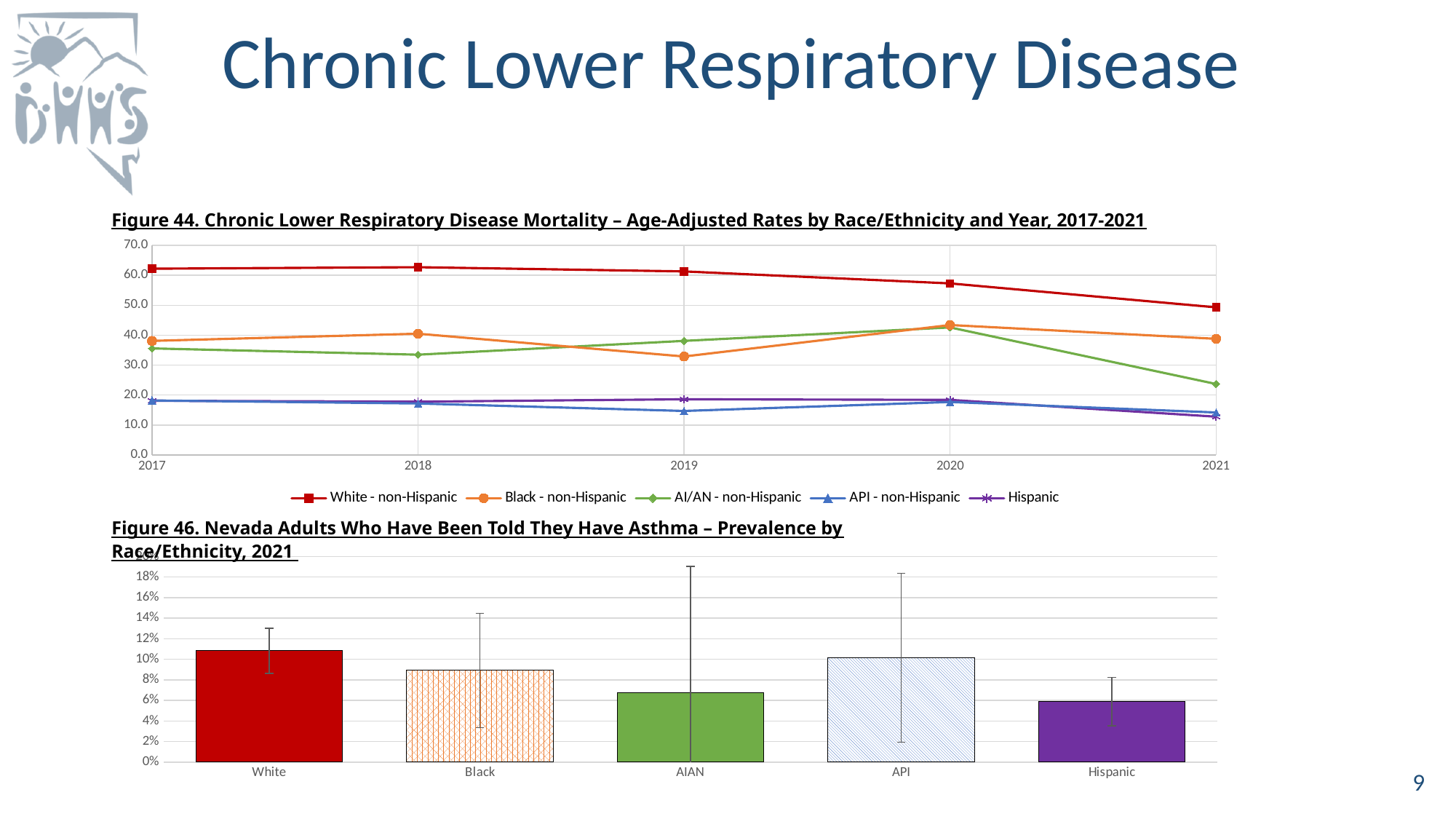
In Figure 44, how many series does the legend list? 5 In Figure 44, does the White - non-Hispanic rate rise or fall between 2019 and 2021? fall In Figure 46, how many race/ethnicity categories are shown? 5 In Figure 46, which is larger: the value for White or Hispanic? White In Figure 44, is the value for White - non-Hispanic in 2017 greater or less than 60.0? greater What kind of chart is Figure 46? bar chart In Figure 44, is the value for AI/AN - non-Hispanic in 2021 greater or less than 30.0? less In Figure 44, which race/ethnicity group has the highest mortality rate in every year shown? White - non-Hispanic In Figure 46, is the value for White greater or less than 10%? greater In Figure 44, which is larger in 2021: the value for Black - non-Hispanic or AI/AN - non-Hispanic? Black - non-Hispanic In Figure 44, how many years are shown on the x axis? 5 What kind of chart is Figure 44? line chart